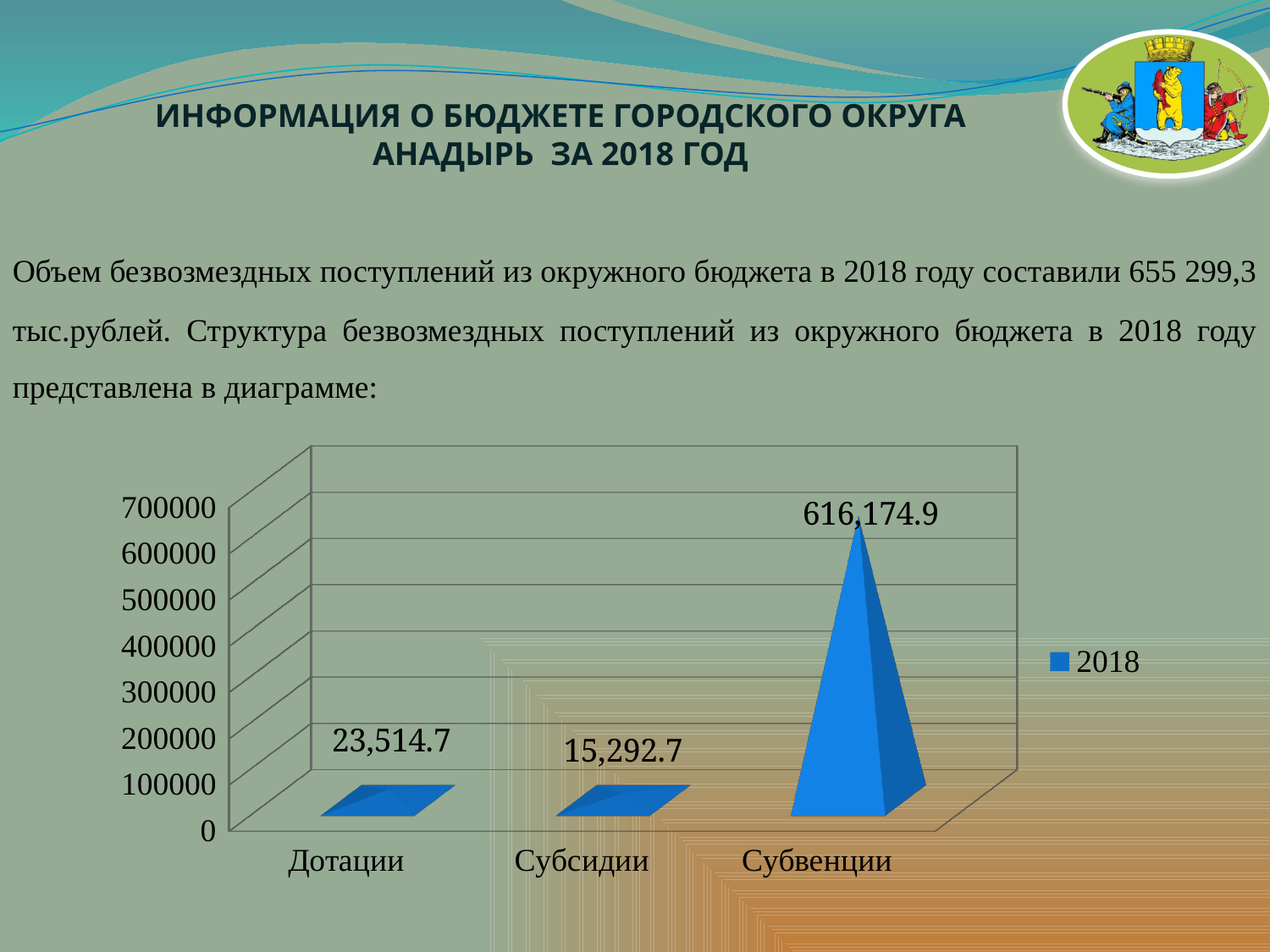
What is the difference between the values for Субвенции and Дотации? 592,660.2 Which category has the highest value? Субвенции What is the value for Субвенции? 616,174.9 What is the value for Дотации? 23,514.7 What is the legend entry for the series shown? 2018 Which category has the lowest value? Субсидии Is the value for Субвенции greater or less than 600000? greater Which is larger, the value for Дотации or the value for Субсидии? Дотации What is the difference between the values for Дотации and Субсидии? 8,222.0 What is the value for Субсидии? 15,292.7 How many categories are shown on the x axis? 3 How many series does the legend list? 1